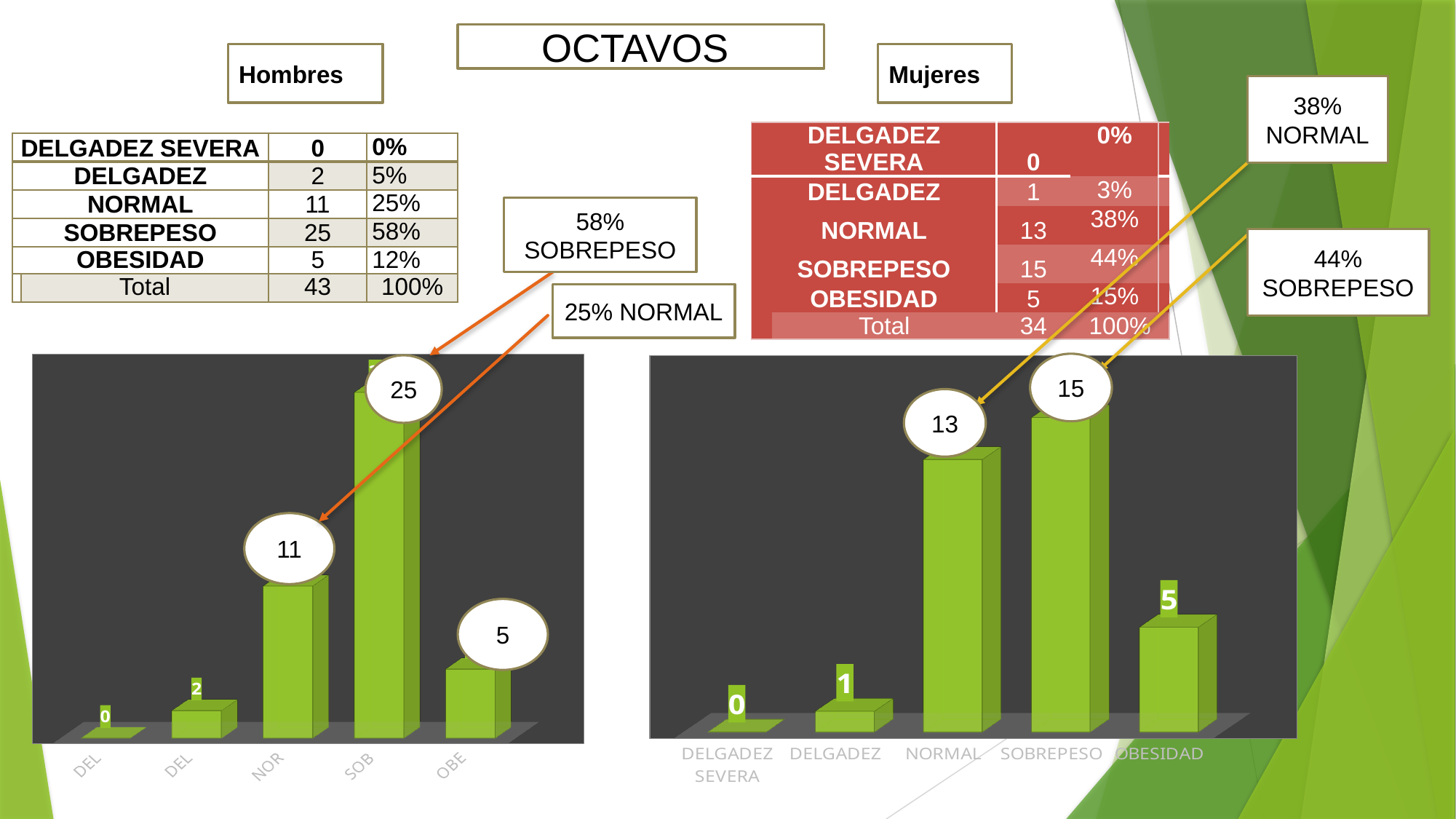
In the left (Hombres) chart, what is the value for SOBREPESO? 25 In the right (Mujeres) chart, which category has the lowest value? DELGADEZ SEVERA In the left (Hombres) chart, which is larger: the value for NORMAL or the value for OBESIDAD? NORMAL In the right (Mujeres) chart, what is the value for OBESIDAD? 5 In the left (Hombres) chart, what is the difference between the SOBREPESO value and the NORMAL value? 14 In the right (Mujeres) chart, what is the value for NORMAL? 13 Which is larger: the SOBREPESO value in the left (Hombres) chart or the SOBREPESO value in the right (Mujeres) chart? Left (Hombres) chart How many categories are shown in the right (Mujeres) chart? 5 In the left (Hombres) chart, which category has the highest value? SOBREPESO What type of chart is the left (Hombres) chart? Bar chart In the right (Mujeres) chart, what is the difference between the SOBREPESO value and the OBESIDAD value? 10 In the right (Mujeres) chart, what is the value for DELGADEZ? 1